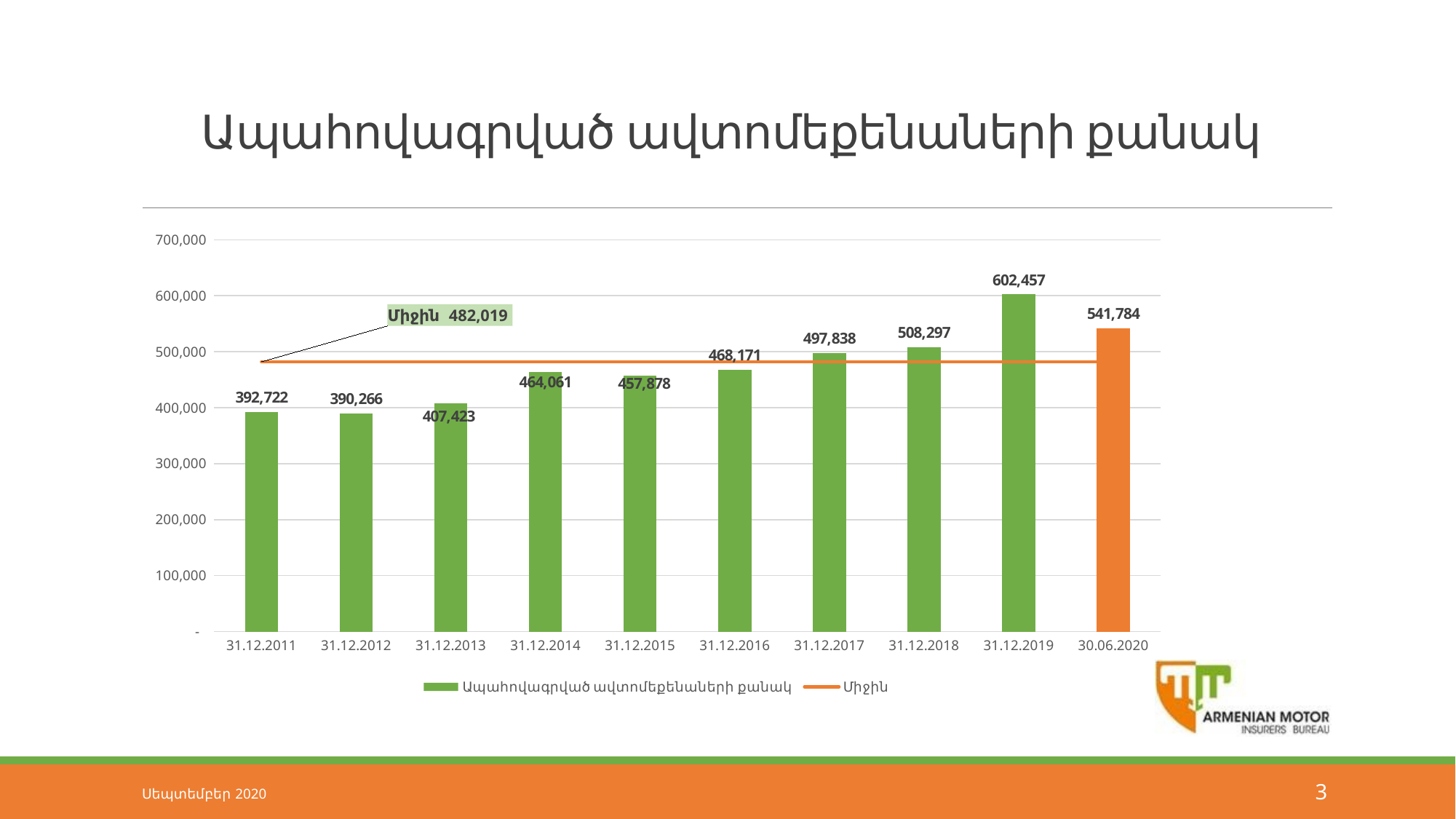
What kind of chart is shown? bar chart What is the difference between the values for 31.12.2019 and 30.06.2020? 60,673 Which date has the highest value? 31.12.2019 What is the value for 30.06.2020? 541,784 Is the value for 31.12.2019 greater or less than 600,000? greater What is the average (Միջին) value shown by the horizontal line? 482,019 Which date has the lowest value? 31.12.2012 What is the value for 31.12.2011? 392,722 What is the value for 31.12.2016? 468,171 How many dates are shown on the x axis? 10 How many series does the legend list? 2 Which is larger, the value for 31.12.2014 or 31.12.2015? 31.12.2014